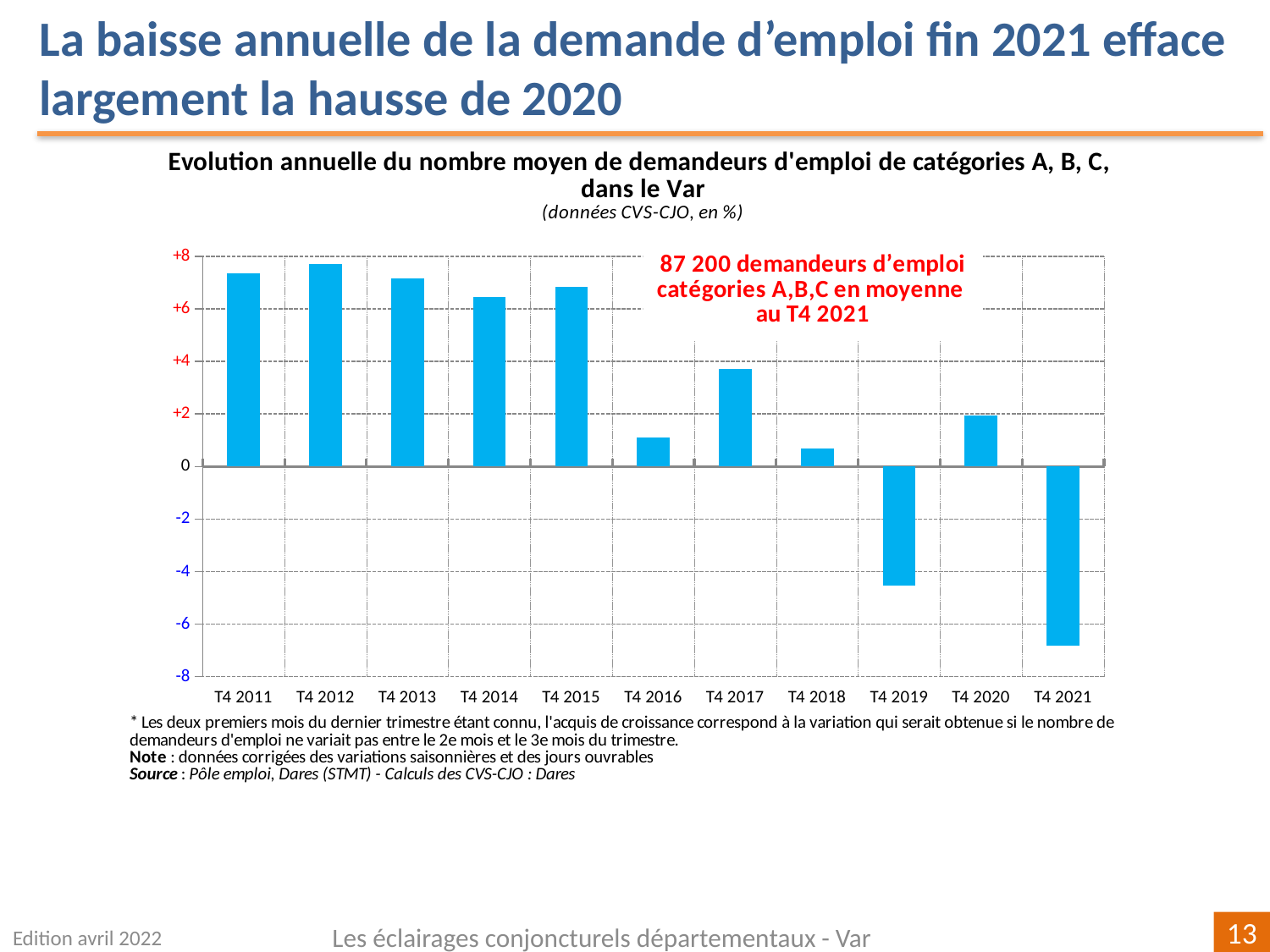
Is the value for T4 2016 greater or less than +2? less Is the value for T4 2011 greater or less than +6? greater What kind of chart is shown on the slide? bar chart Which is larger, the value for T4 2017 or the value for T4 2018? T4 2017 Which quarter has the lowest value in the chart? T4 2021 Do the values generally rise or fall from T4 2011 to T4 2016? fall According to the annotation on the chart, how many demandeurs d'emploi of categories A, B, C were there on average in T4 2021? 87 200 Is the value for T4 2017 greater or less than +4? less How many quarters (categories) are plotted on the x axis? 11 Which is larger, the value for T4 2019 or the value for T4 2021? T4 2019